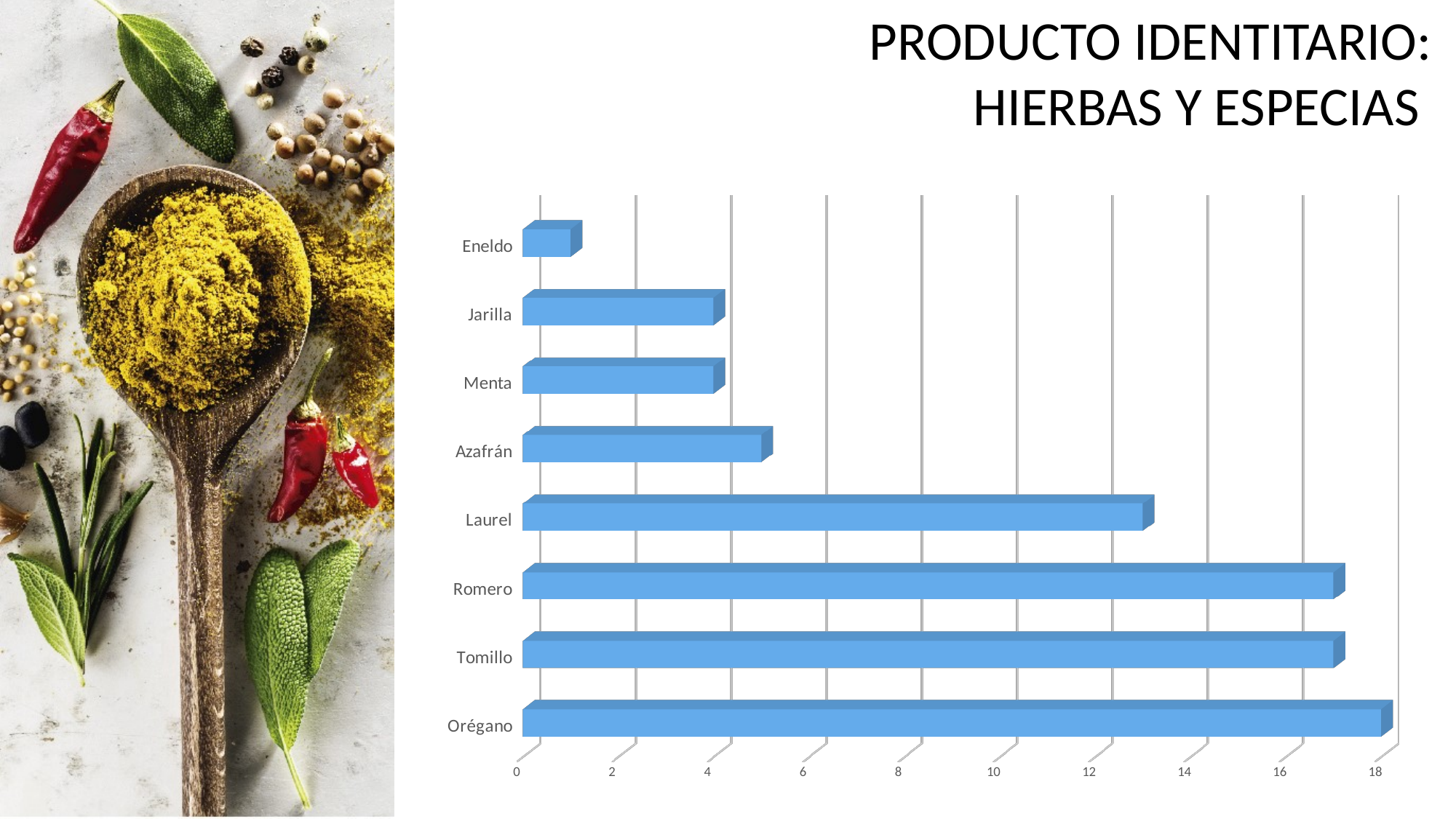
Which has a larger value, Laurel or Azafrán? Laurel Which has a larger value, Eneldo or Orégano? Orégano Is the value for Laurel greater or less than 14? less What is the title shown above the chart on the slide? PRODUCTO IDENTITARIO: HIERBAS Y ESPECIAS Is the value for Jarilla greater or less than 6? less Which category has the lowest value in the chart? Eneldo How many categories (herbs and spices) are plotted in the chart? 8 Is the value for Eneldo greater or less than 2? less What kind of chart is shown on the slide? bar chart Which category has the highest value in the chart? Orégano